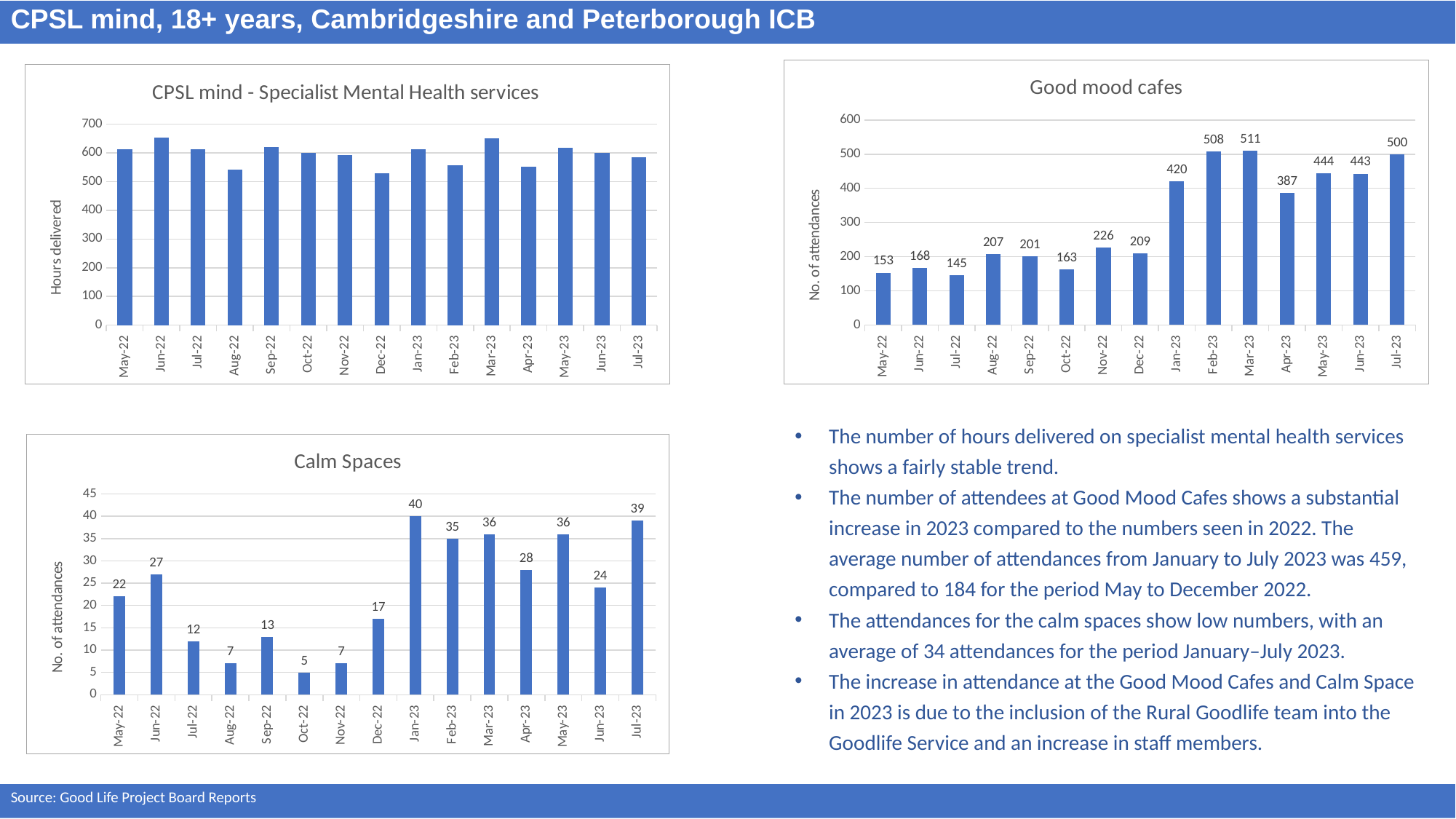
In the Calm Spaces chart, what is the difference between the Jul-23 and Jun-23 values? 15 In the Good mood cafes chart, which month has the lowest number of attendances? Jul-22 In the CPSL mind - Specialist Mental Health services chart, is the value for Aug-22 greater or less than 600? less In the Calm Spaces chart, how many attendances were there in Jan-23? 40 In the Good mood cafes chart, how many attendances were there in Feb-23? 508 In the CPSL mind - Specialist Mental Health services chart, is the value for Jun-22 greater or less than 600? greater In the Good mood cafes chart, what is the difference in attendances between Jan-23 and Dec-22? 211 In the Calm Spaces chart, which month has the lowest number of attendances? Oct-22 How many months are plotted in the Calm Spaces chart? 15 In the Calm Spaces chart, which is larger, the value for Jun-22 or the value for Apr-23? Apr-23 What type of chart is the Good mood cafes chart? Bar chart In the Good mood cafes chart, which month has the highest number of attendances? Mar-23